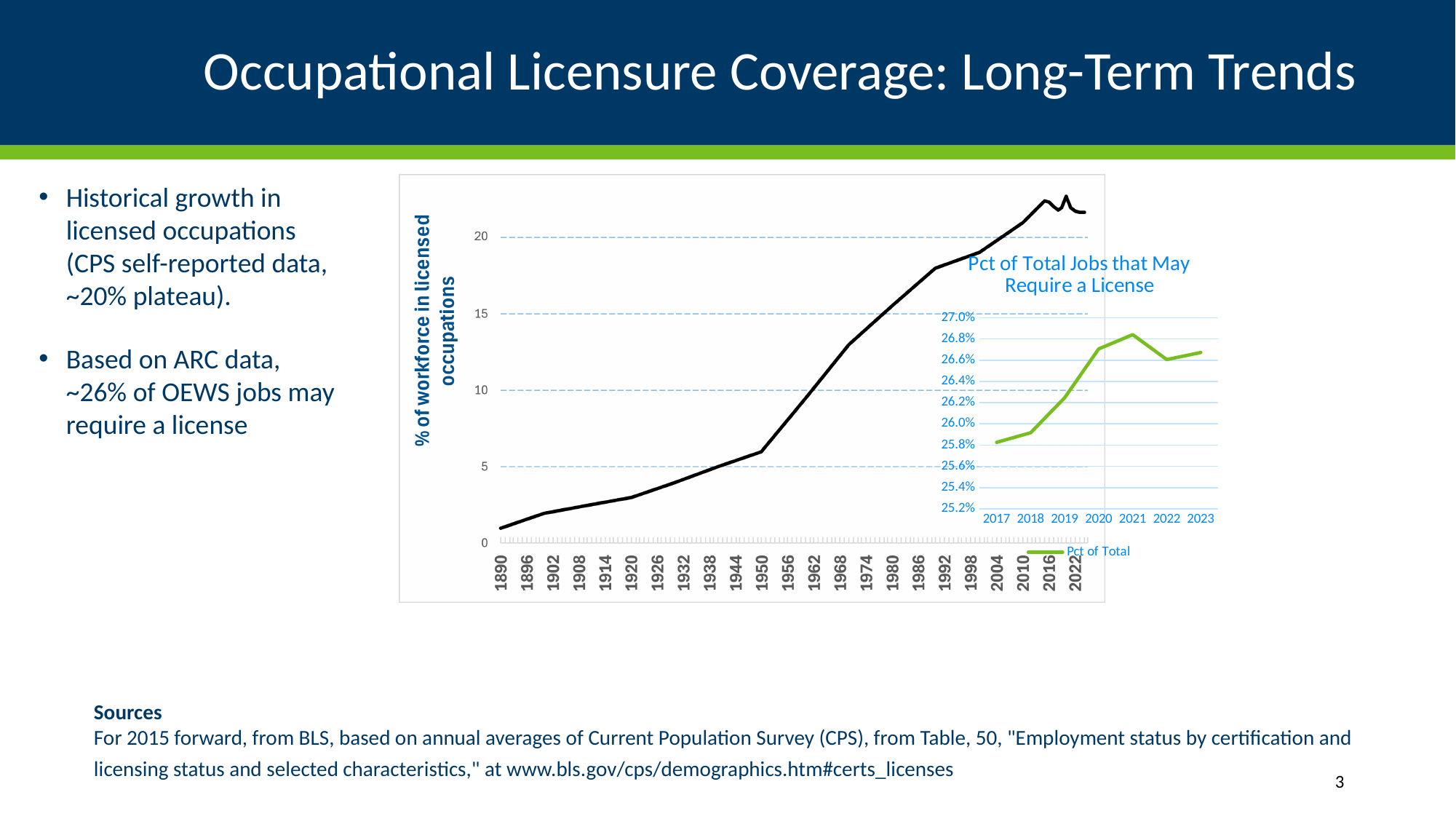
In the inset chart 'Pct of Total Jobs that May Require a License', how many series does the legend list? 1 In the inset chart 'Pct of Total Jobs that May Require a License', which year has the highest value? 2021 In the inset chart 'Pct of Total Jobs that May Require a License', which year has the lowest value? 2017 What kind of chart is the large chart showing % of workforce in licensed occupations? line chart In the large chart of % of workforce in licensed occupations, is the value for 1992 greater or less than 15? greater In the inset chart 'Pct of Total Jobs that May Require a License', how many years are plotted on the x axis? 7 In the large chart of % of workforce in licensed occupations, which is larger, the value for 1950 or the value for 1992? 1992 In the large chart of % of workforce in licensed occupations, is the value for 1890 greater or less than 5? less In the inset chart 'Pct of Total Jobs that May Require a License', which is larger, the value for 2018 or the value for 2020? 2020 In the large chart of % of workforce in licensed occupations, do the values generally rise or fall from 1890 to 2016? rise In the inset chart 'Pct of Total Jobs that May Require a License', is the value for 2017 greater or less than 26.0%? less